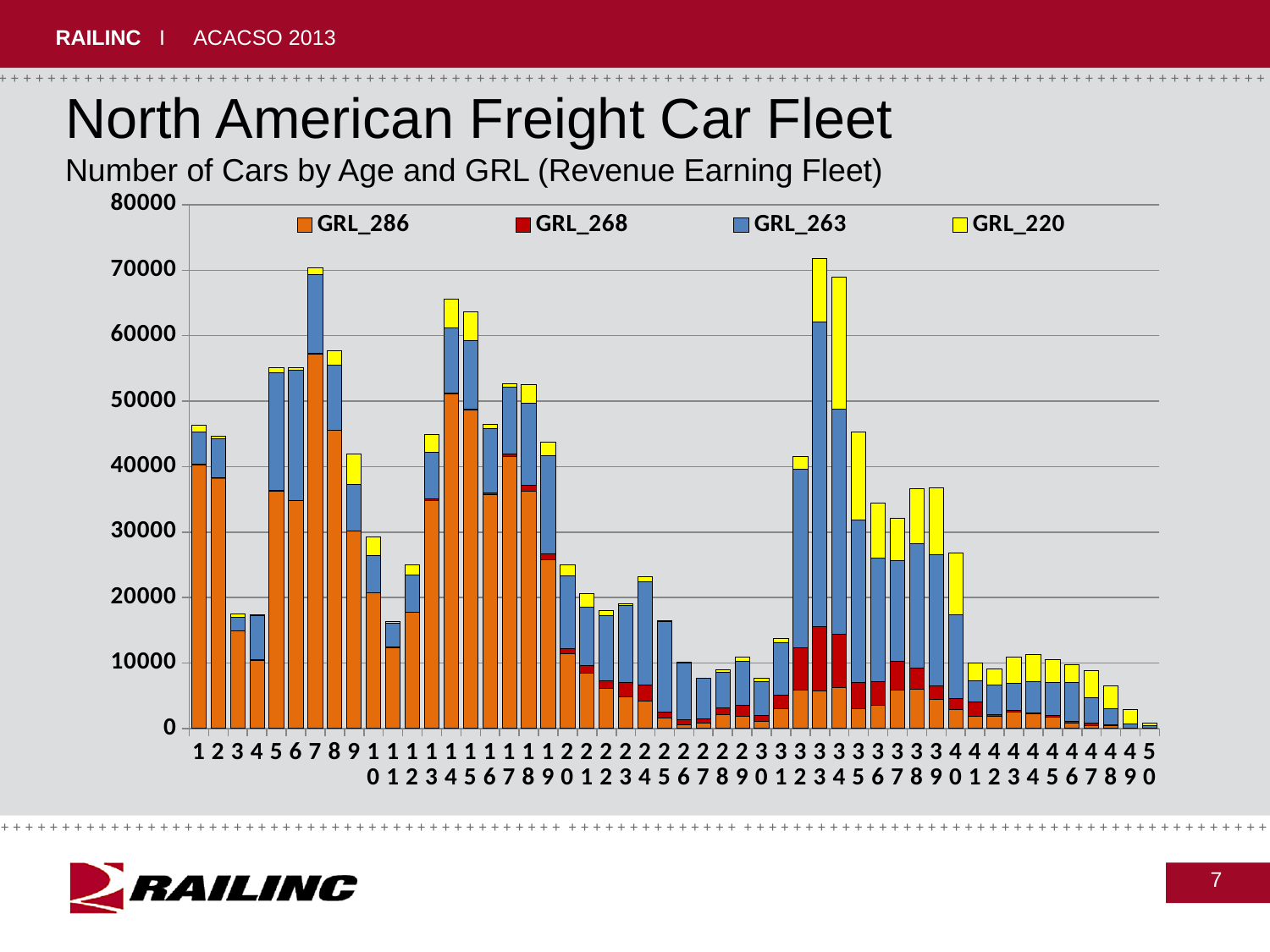
What is the subtitle of the chart? Number of Cars by Age and GRL (Revenue Earning Fleet) Which has a larger total number of cars, age 1 or age 3? Age 1 What kind of chart is shown on the slide? Stacked bar chart Is the total number of cars for age 50 greater or less than 10000? less Is the total number of cars for age 1 greater or less than 40000? greater Is the total number of cars for age 33 greater or less than 70000? greater Do the total bar heights rise or fall from age 44 to age 50? Fall Which series is shown in orange in the legend? GRL_286 How many age categories are plotted along the x axis? 50 How many series does the legend list? 4 Which has a larger total number of cars, age 33 or age 40? Age 33